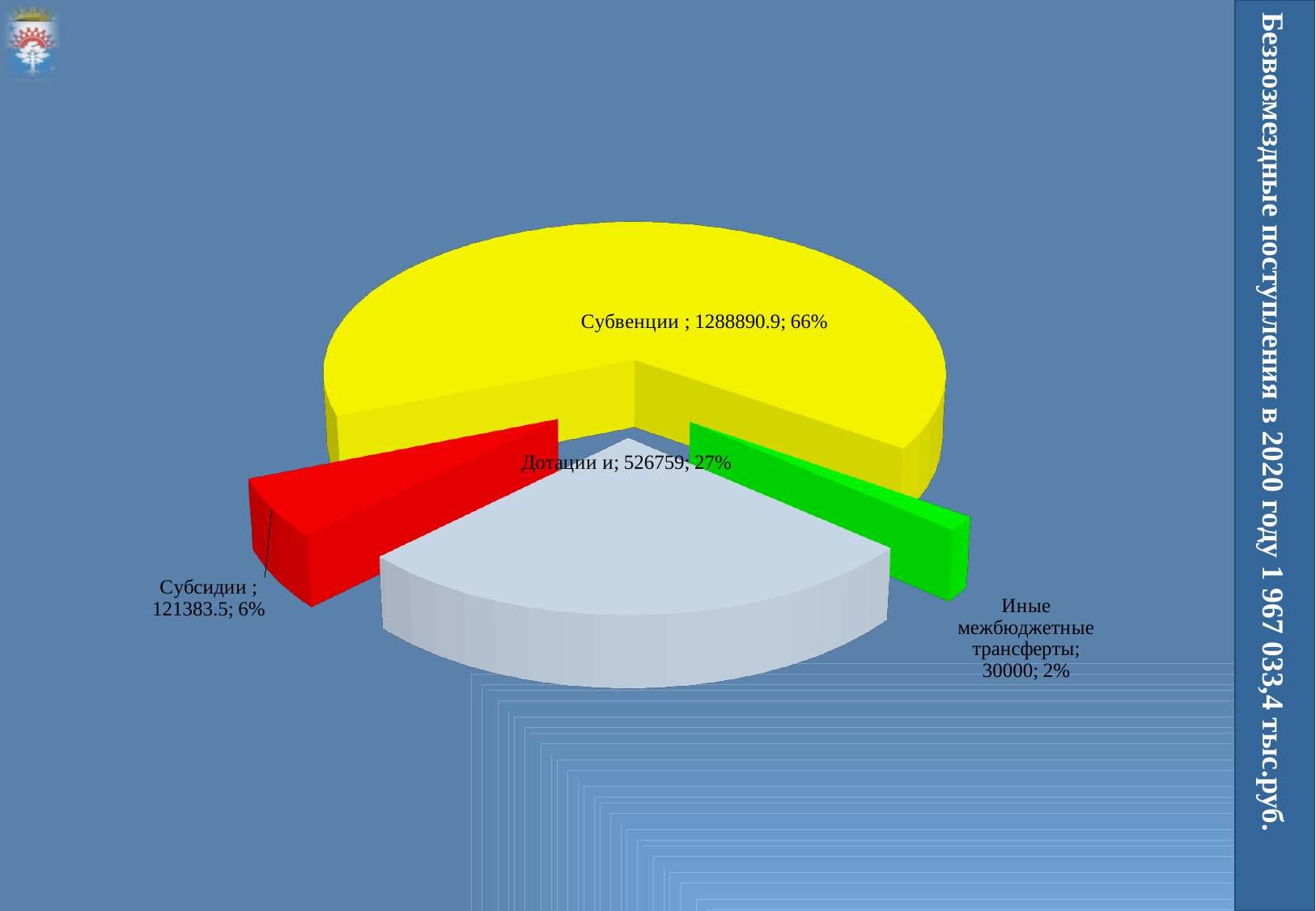
How many slices does the pie chart have? 4 What is the value shown for Субвенции? 1288890.9 Which is larger, the value for Дотации or the value for Субсидии? Дотации What percentage share does the Иные межбюджетные трансферты slice have? 2% What percentage share does the Дотации slice have? 27% What is the value shown for Дотации? 526759 What is the value shown for Субсидии? 121383.5 Which category has the largest share of the pie? Субвенции Which category has the smallest share of the pie? Иные межбюджетные трансферты What type of chart is shown on the slide? Pie chart What percentage share does the Субвенции slice have? 66% What colour is the Субвенции slice? Yellow